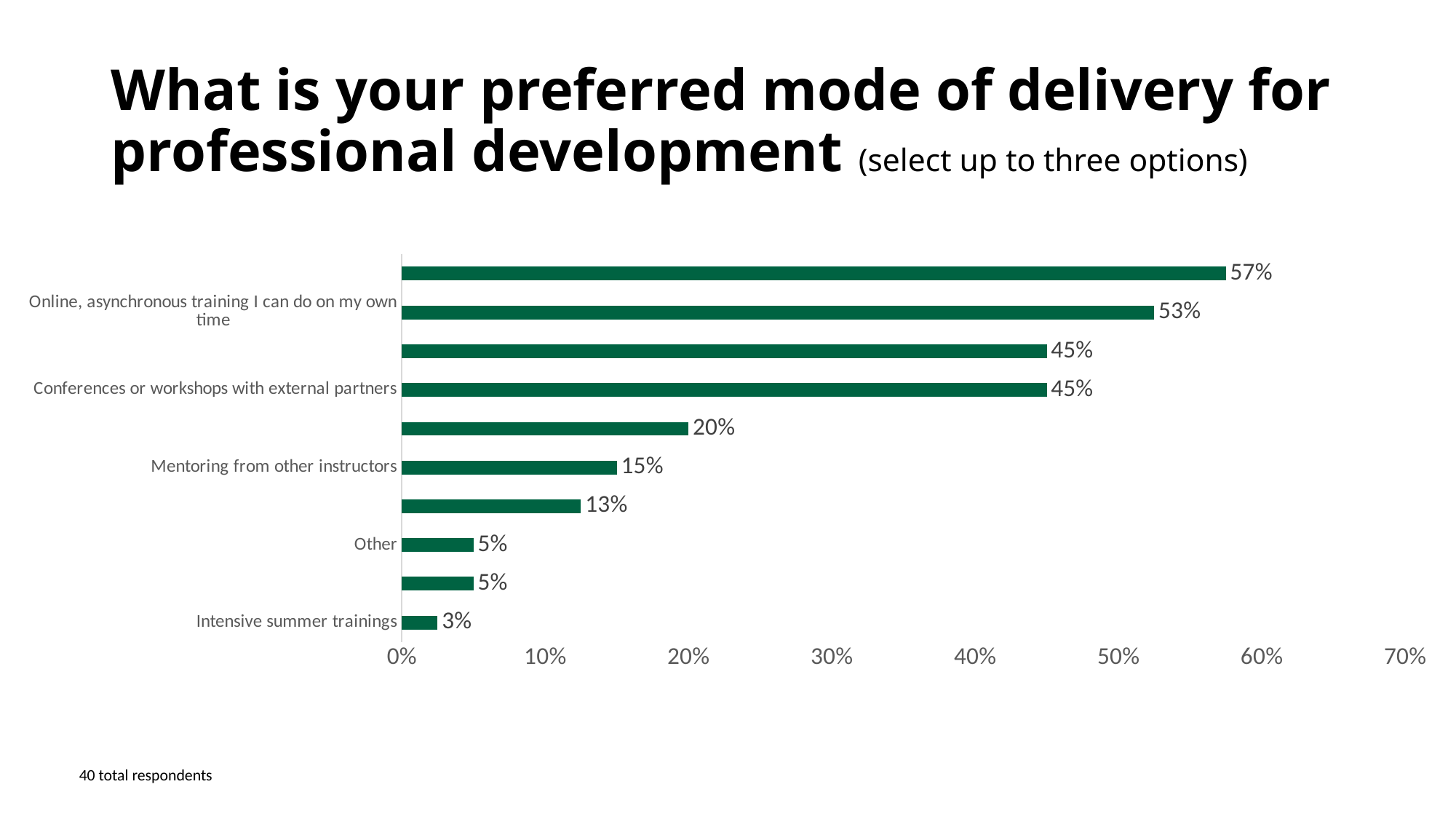
What is the difference between "Online, asynchronous training I can do on my own time" and "Conferences or workshops with external partners"? 8% How many bars are plotted on the chart? 10 How many total respondents does the slide report? 40 What is the highest value shown on the chart? 57% What percentage of respondents preferred "Online, asynchronous training I can do on my own time"? 53% What is the value for "Mentoring from other instructors"? 15% What is the value for "Conferences or workshops with external partners"? 45% Which is larger: "Mentoring from other instructors" or "Conferences or workshops with external partners"? Conferences or workshops with external partners Which labelled category has the lowest value? Intensive summer trainings What is the value for "Intensive summer trainings"? 3% What kind of chart is shown on the slide? bar chart What is the value for "Other"? 5%